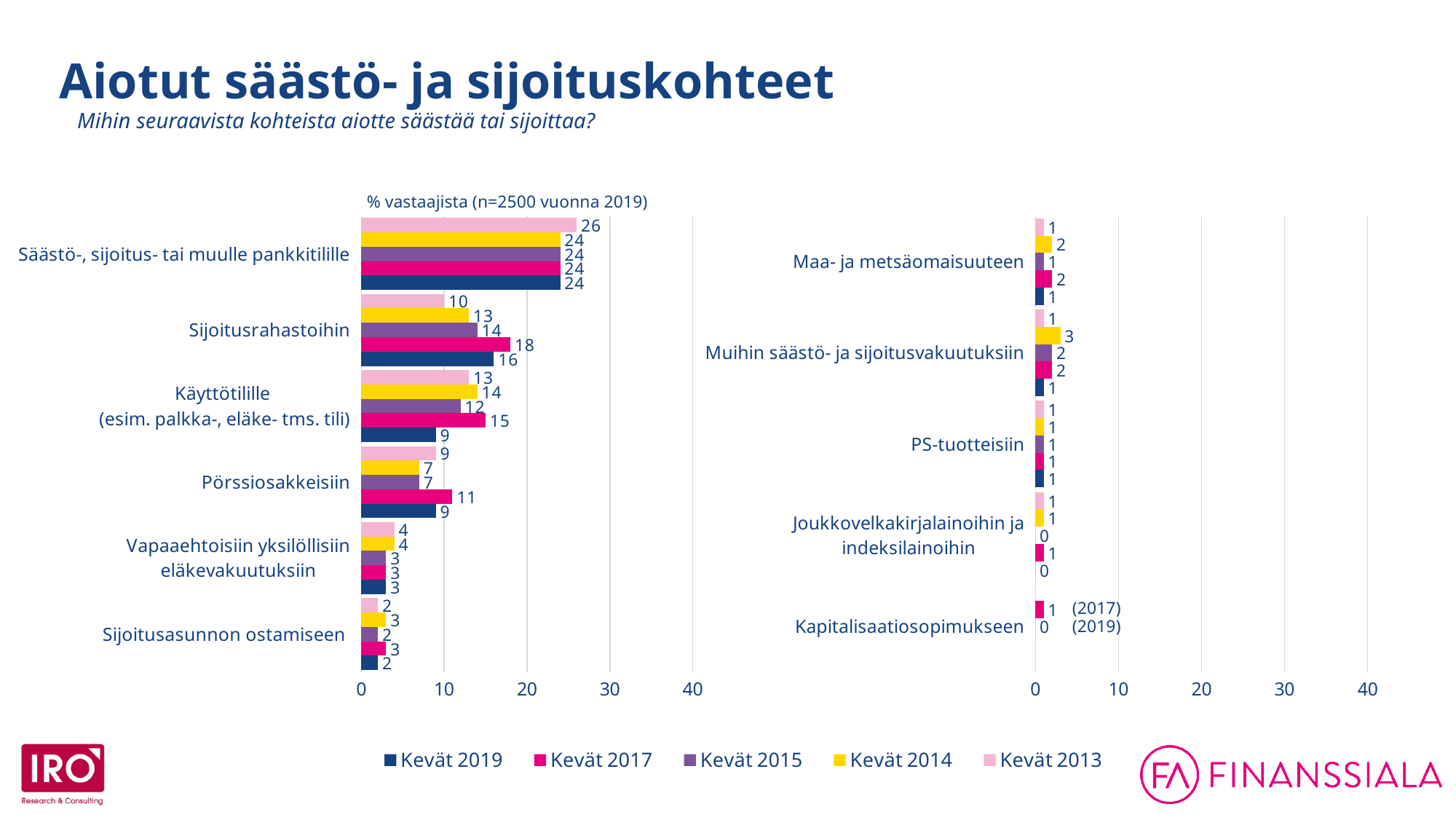
What kind of chart is shown on the left of the slide? Bar chart In the left chart, what is the Kevät 2019 value for Sijoitusrahastoihin? 16 In the left chart, what is the Kevät 2017 value for Käyttötilille (esim. palkka-, eläke- tms. tili)? 15 How many categories are shown in the right chart? 5 In the right chart, what is the Kevät 2019 value for Kapitalisaatiosopimukseen? 0 In the left chart, which category has the highest Kevät 2019 value? Säästö-, sijoitus- tai muulle pankkitilille In the left chart, what is the Kevät 2013 value for Säästö-, sijoitus- tai muulle pankkitilille? 26 How many series does the legend list? 5 In the left chart, what is the difference between the Kevät 2017 and Kevät 2019 values for Sijoitusrahastoihin? 2 In the left chart, for Pörssiosakkeisiin, which is larger: the Kevät 2017 value or the Kevät 2019 value? Kevät 2017 In the right chart, what is the Kevät 2014 value for Muihin säästö- ja sijoitusvakuutuksiin? 3